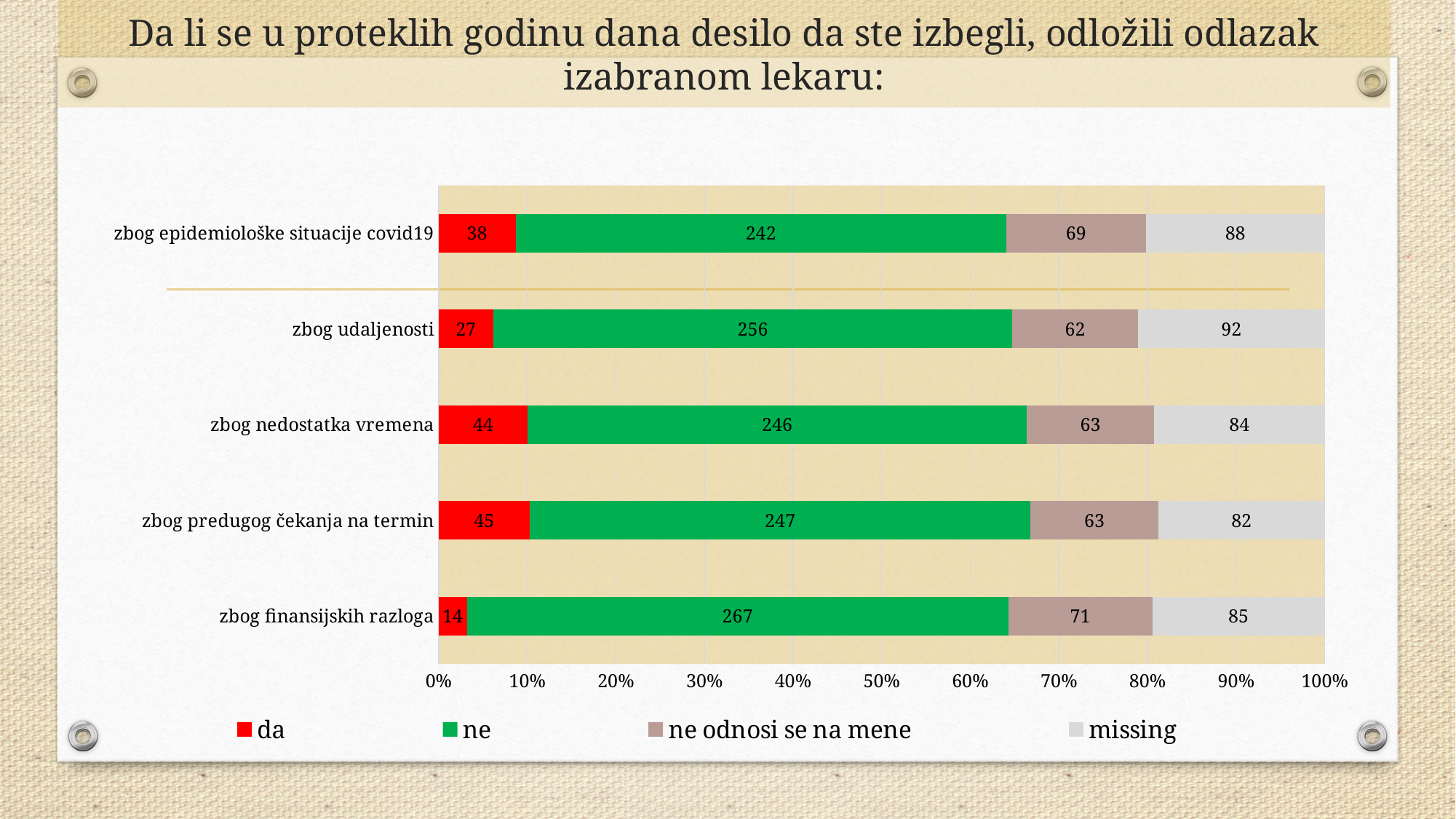
How many categories are shown on the chart? 5 What is the value of "missing" for "zbog epidemiološke situacije covid19"? 88 What is the value of "ne odnosi se na mene" for "zbog finansijskih razloga"? 71 Which category has the lowest value for "da"? zbog finansijskih razloga What is the total of the stacked bar for "zbog nedostatka vremena"? 437 What is the value of "ne" for "zbog udaljenosti"? 256 Which category has the highest value for "ne"? zbog finansijskih razloga How many series does the legend list? 4 What is the value of "da" for "zbog predugog čekanja na termin"? 45 What is the difference between the "ne" values for "zbog finansijskih razloga" and "zbog epidemiološke situacije covid19"? 25 Which is larger: the "missing" value for "zbog udaljenosti" or for "zbog nedostatka vremena"? zbog udaljenosti What kind of chart is shown on the slide? stacked bar chart